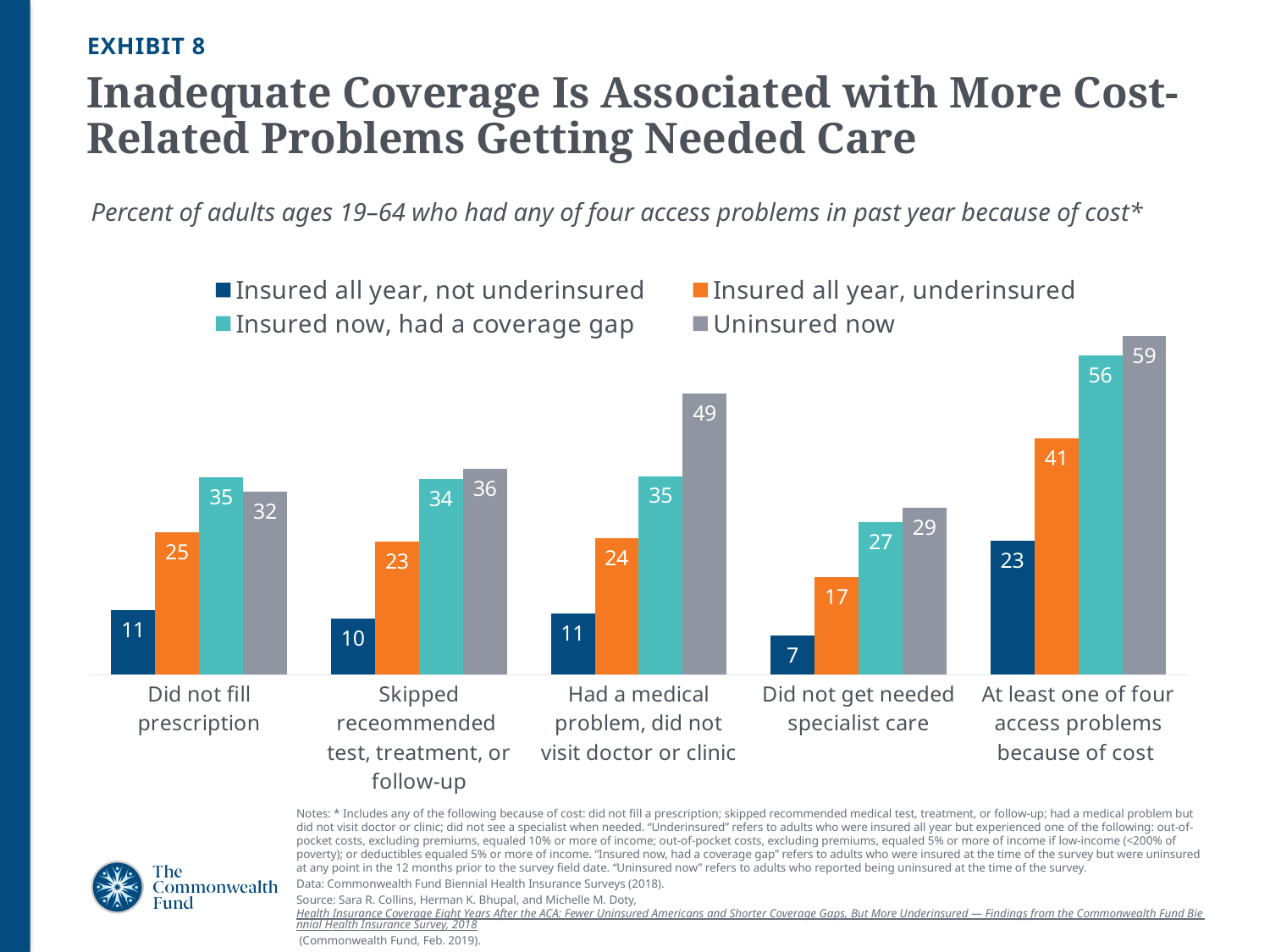
Which category has the lowest value for 'Insured all year, not underinsured'? Did not get needed specialist care What is the value for 'Insured now, had a coverage gap' in the 'At least one of four access problems because of cost' category? 56 What is the difference between 'Insured all year, underinsured' and 'Insured all year, not underinsured' in the 'Did not fill prescription' category? 14 What kind of chart is shown on the slide? Bar chart What colour represents the 'Uninsured now' series in the legend? Gray Which category has the highest value for 'Uninsured now'? At least one of four access problems because of cost How many series does the legend list? 4 In the 'Skipped recommended test, treatment, or follow-up' category, which is larger: 'Insured now, had a coverage gap' or 'Insured all year, underinsured'? Insured now, had a coverage gap How many categories are shown on the x axis? 5 What is the value for 'Uninsured now' in the 'Did not fill prescription' category? 32 What is the difference between 'Uninsured now' and 'Insured all year, not underinsured' in the 'Had a medical problem, did not visit doctor or clinic' category? 38 What is the value for 'Insured all year, underinsured' in the 'Did not get needed specialist care' category? 17